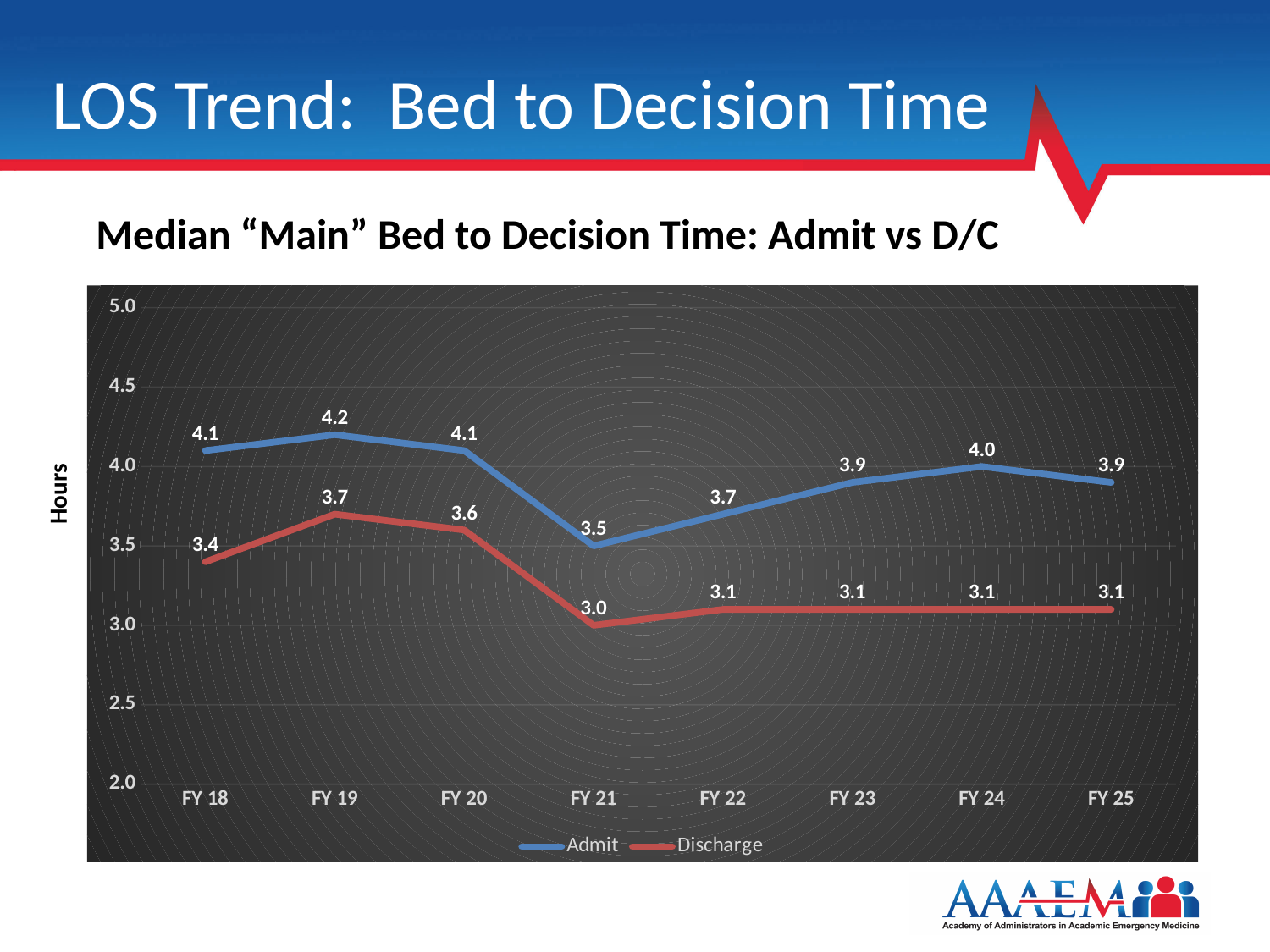
What is the Admit value for FY 24? 4.0 What is the label on the vertical axis? Hours In which fiscal year is the Discharge value lowest? FY 21 In which fiscal year is the Admit value highest? FY 19 How many fiscal years are shown on the x axis? 8 What kind of chart is this? Line chart What is the difference between the Admit and Discharge values in FY 18? 0.7 What is the Admit value for FY 21? 3.5 How many series does the legend list? 2 Does the Discharge value rise or fall from FY 20 to FY 21? Fall What is the Discharge value for FY 19? 3.7 Which is larger in FY 25, the Admit value or the Discharge value? Admit